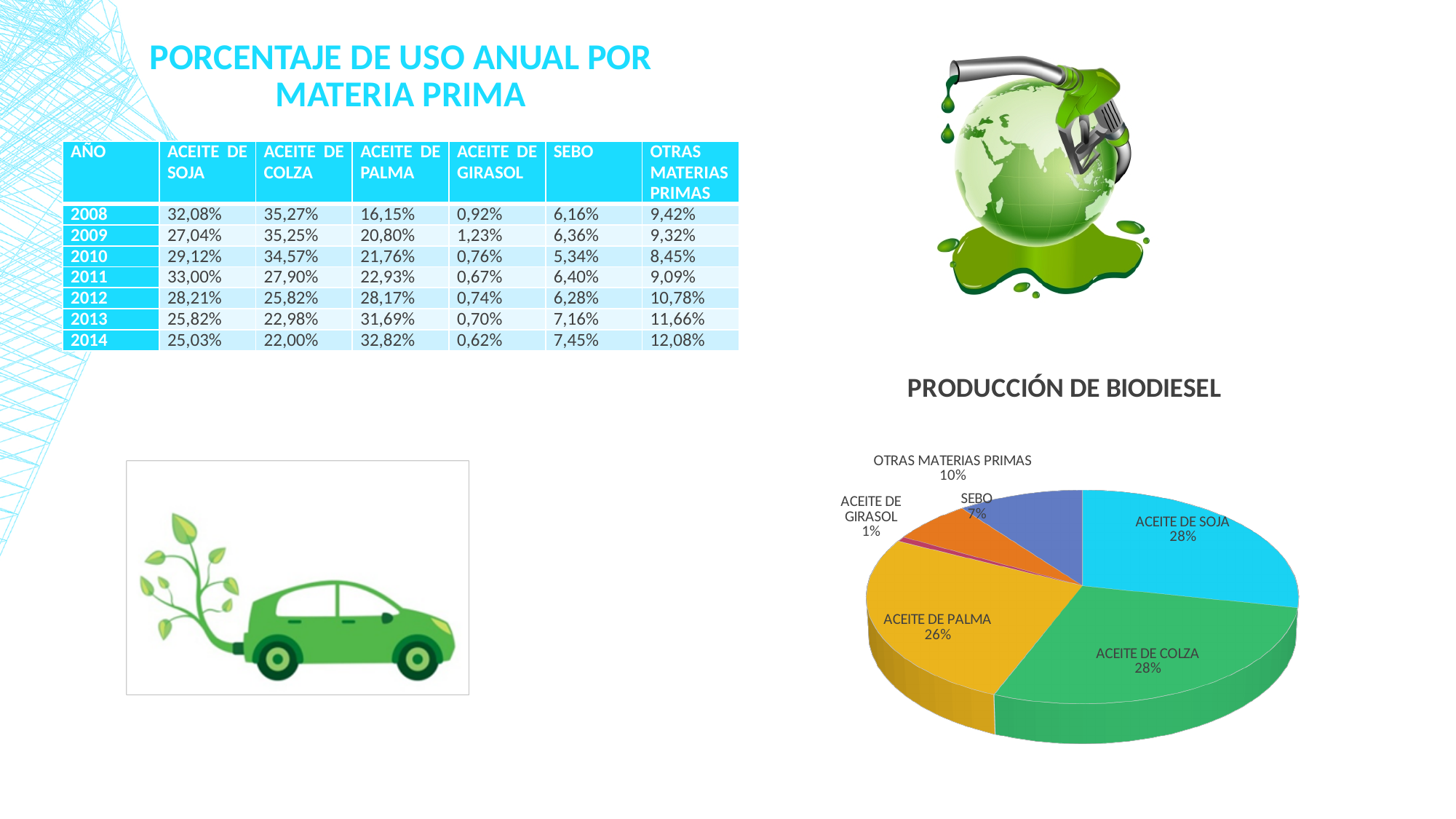
In the PRODUCCIÓN DE BIODIESEL pie chart, what is the difference in percentage points between ACEITE DE COLZA and SEBO? 21 What is the title of the pie chart on the slide? PRODUCCIÓN DE BIODIESEL In the PRODUCCIÓN DE BIODIESEL pie chart, which is larger, OTRAS MATERIAS PRIMAS or ACEITE DE GIRASOL? OTRAS MATERIAS PRIMAS In the PRODUCCIÓN DE BIODIESEL pie chart, what share does ACEITE DE PALMA have? 26% In the PRODUCCIÓN DE BIODIESEL pie chart, which slice has the smallest share? ACEITE DE GIRASOL In the PRODUCCIÓN DE BIODIESEL pie chart, how many slices are there? 6 In the PRODUCCIÓN DE BIODIESEL pie chart, what is the difference in percentage points between ACEITE DE PALMA and OTRAS MATERIAS PRIMAS? 16 In the PRODUCCIÓN DE BIODIESEL pie chart, what percentage is shown for ACEITE DE SOJA? 28% In the PRODUCCIÓN DE BIODIESEL pie chart, what percentage is shown for OTRAS MATERIAS PRIMAS? 10% In the PRODUCCIÓN DE BIODIESEL pie chart, which is larger, ACEITE DE PALMA or SEBO? ACEITE DE PALMA What kind of chart is shown under the title PRODUCCIÓN DE BIODIESEL? Pie chart In the PRODUCCIÓN DE BIODIESEL pie chart, what percentage is shown for SEBO? 7%